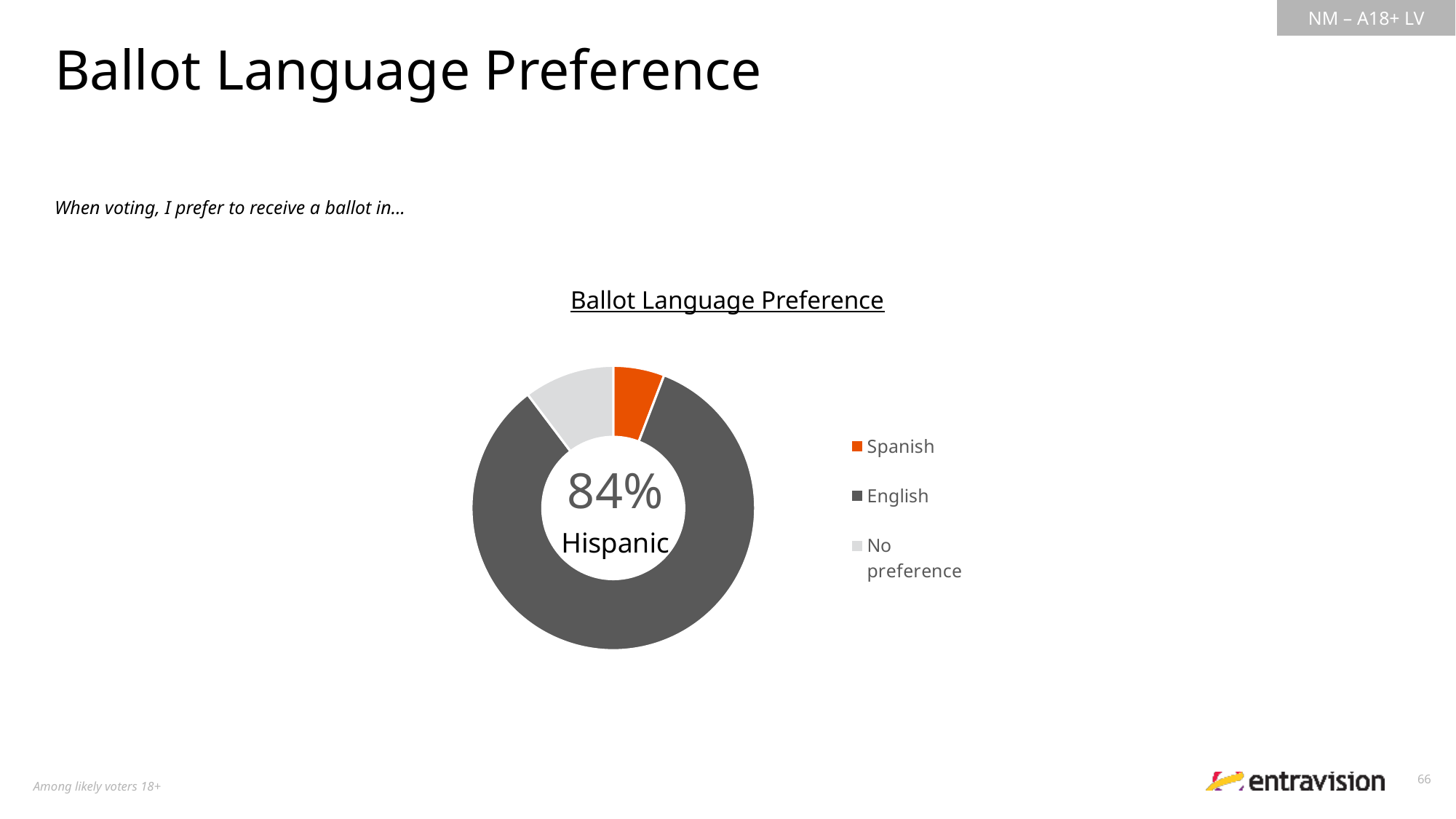
What kind of chart is shown on the slide? pie chart (donut) What is the title of the chart on the slide? Ballot Language Preference What word is printed below the 84% in the centre of the donut chart? Hispanic Which slice is larger in the Ballot Language Preference chart, English or No preference? English How many categories does the legend of the Ballot Language Preference chart list? 3 Which category has the largest slice in the Ballot Language Preference chart? English Which category has the smallest slice in the Ballot Language Preference chart? Spanish What percentage is printed in the centre of the donut chart? 84% What colour represents Spanish in the chart? orange Which slice is larger in the Ballot Language Preference chart, Spanish or No preference? No preference